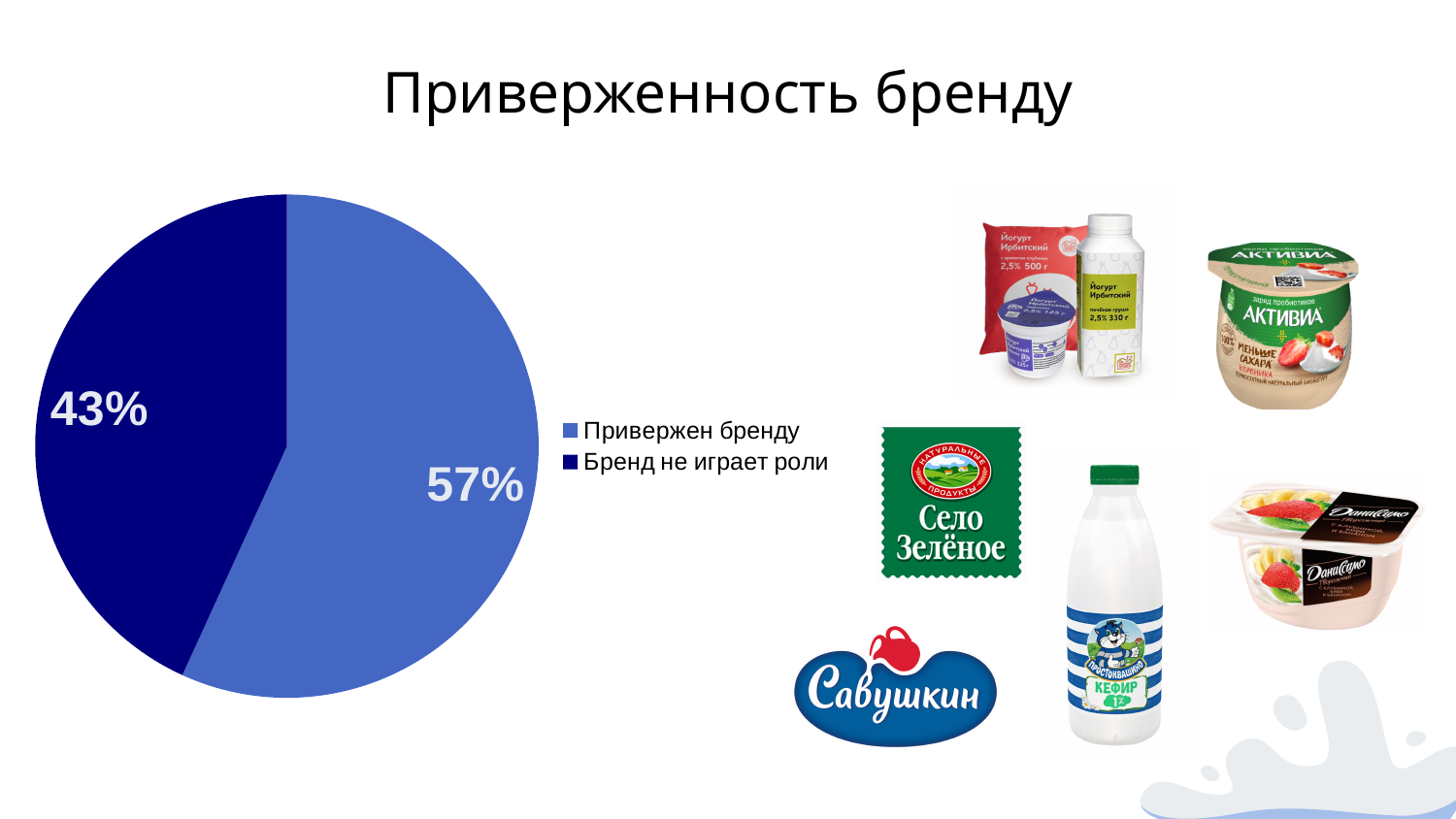
What is the title of the slide containing the pie chart? Приверженность бренду What kind of chart is shown on the slide? pie chart Which slice of the pie is the largest? Привержен бренду What is the difference in percentage points between the "Привержен бренду" and "Бренд не играет роли" slices? 14 Which legend entry is shown in the dark navy colour? Бренд не играет роли Is the share for "Привержен бренду" greater or less than 50%? greater How many slices does the pie chart have? 2 How many entries does the legend list? 2 Which slice of the pie is the smallest? Бренд не играет роли What share of the pie is labelled "Привержен бренду"? 57% What share of the pie is labelled "Бренд не играет роли"? 43% Which is larger: the "Привержен бренду" slice or the "Бренд не играет роли" slice? Привержен бренду